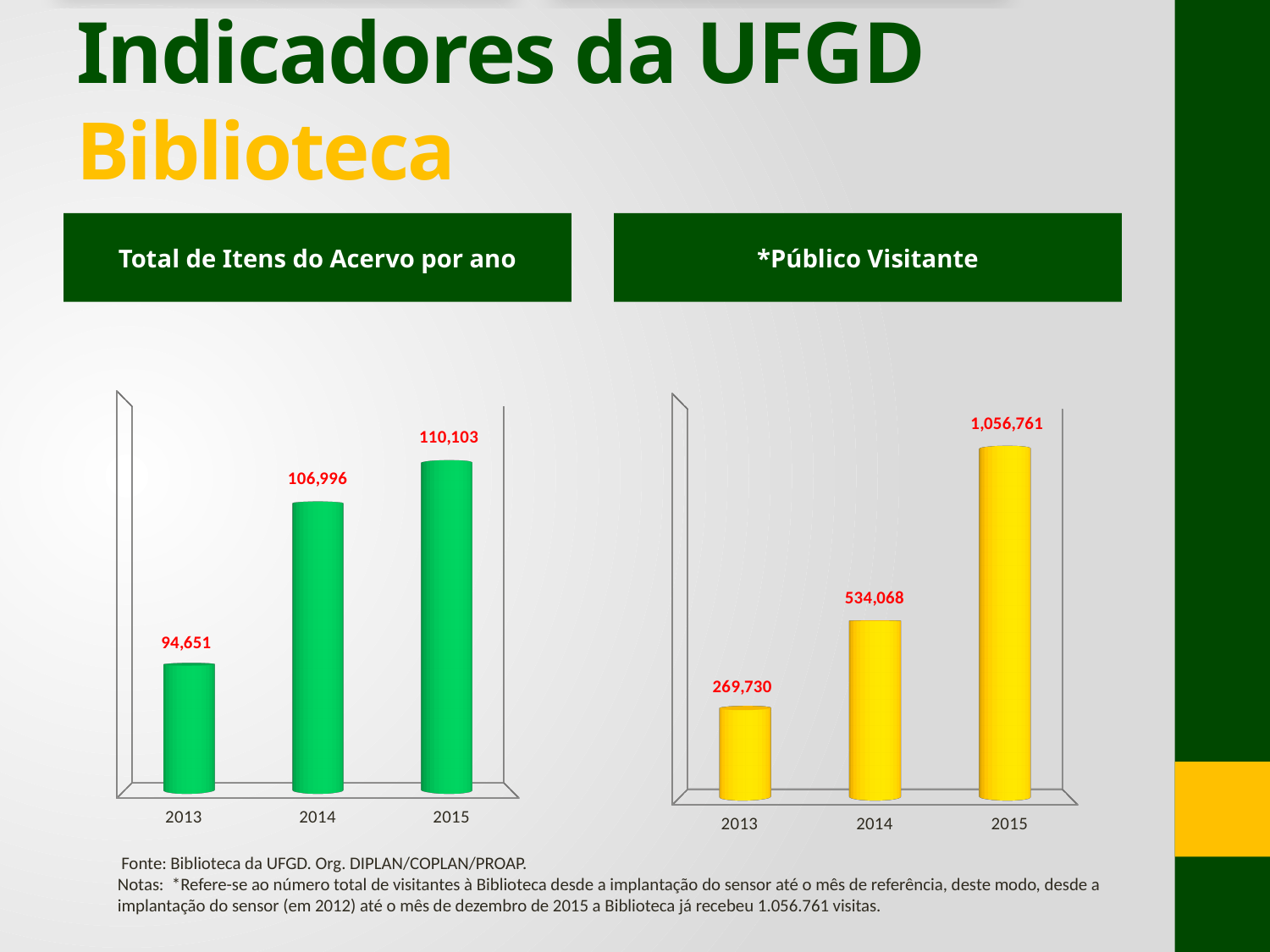
In the '*Público Visitante' chart, do the values rise or fall from 2013 to 2015? Rise In the 'Total de Itens do Acervo por ano' chart, what is the difference between the 2015 and 2013 values? 15,452 In the '*Público Visitante' chart, what is the difference between the 2015 and 2014 values? 522,693 In the 'Total de Itens do Acervo por ano' chart, what is the value for 2014? 106,996 In the 'Total de Itens do Acervo por ano' chart, which year has the highest value? 2015 In the '*Público Visitante' chart, what is the value for 2015? 1,056,761 In the '*Público Visitante' chart, which year has the lowest value? 2013 In the '*Público Visitante' chart, what is the value for 2013? 269,730 What kind of chart is the '*Público Visitante' chart? Bar chart How many years are shown in the 'Total de Itens do Acervo por ano' chart? 3 In the '*Público Visitante' chart, which is larger, the value for 2014 or the value for 2013? 2014 In the 'Total de Itens do Acervo por ano' chart, what is the value for 2013? 94,651